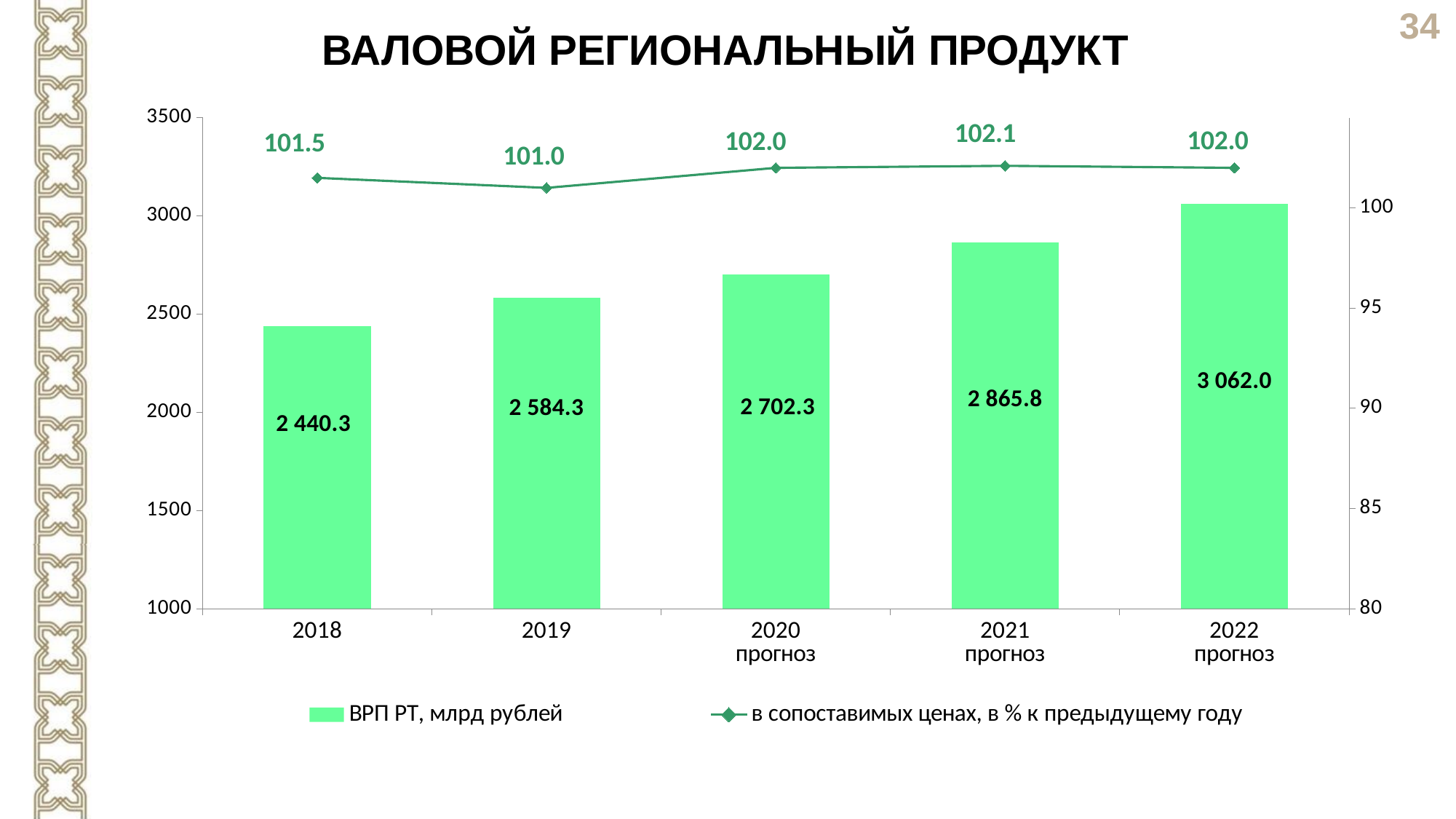
What is the value of ВРП РТ, млрд рублей for 2021 прогноз? 2 865.8 What is the value of the series 'в сопоставимых ценах, в % к предыдущему году' for 2021 прогноз? 102.1 How many years are shown on the x axis? 5 What kind of chart is shown on the slide? Combined bar and line chart Which year has the highest value of ВРП РТ, млрд рублей? 2022 прогноз What is the difference in ВРП РТ, млрд рублей between 2022 прогноз and 2018? 621.7 Which is larger: ВРП РТ, млрд рублей for 2019 or for 2020 прогноз? 2020 прогноз How many series does the legend list? 2 Which year has the lowest value of the series 'в сопоставимых ценах, в % к предыдущему году'? 2019 What is the value of ВРП РТ, млрд рублей for 2018? 2 440.3 Do the values of ВРП РТ, млрд рублей rise or fall from 2018 to 2022 прогноз? Rise What is the value of the series 'в сопоставимых ценах, в % к предыдущему году' for 2019? 101.0